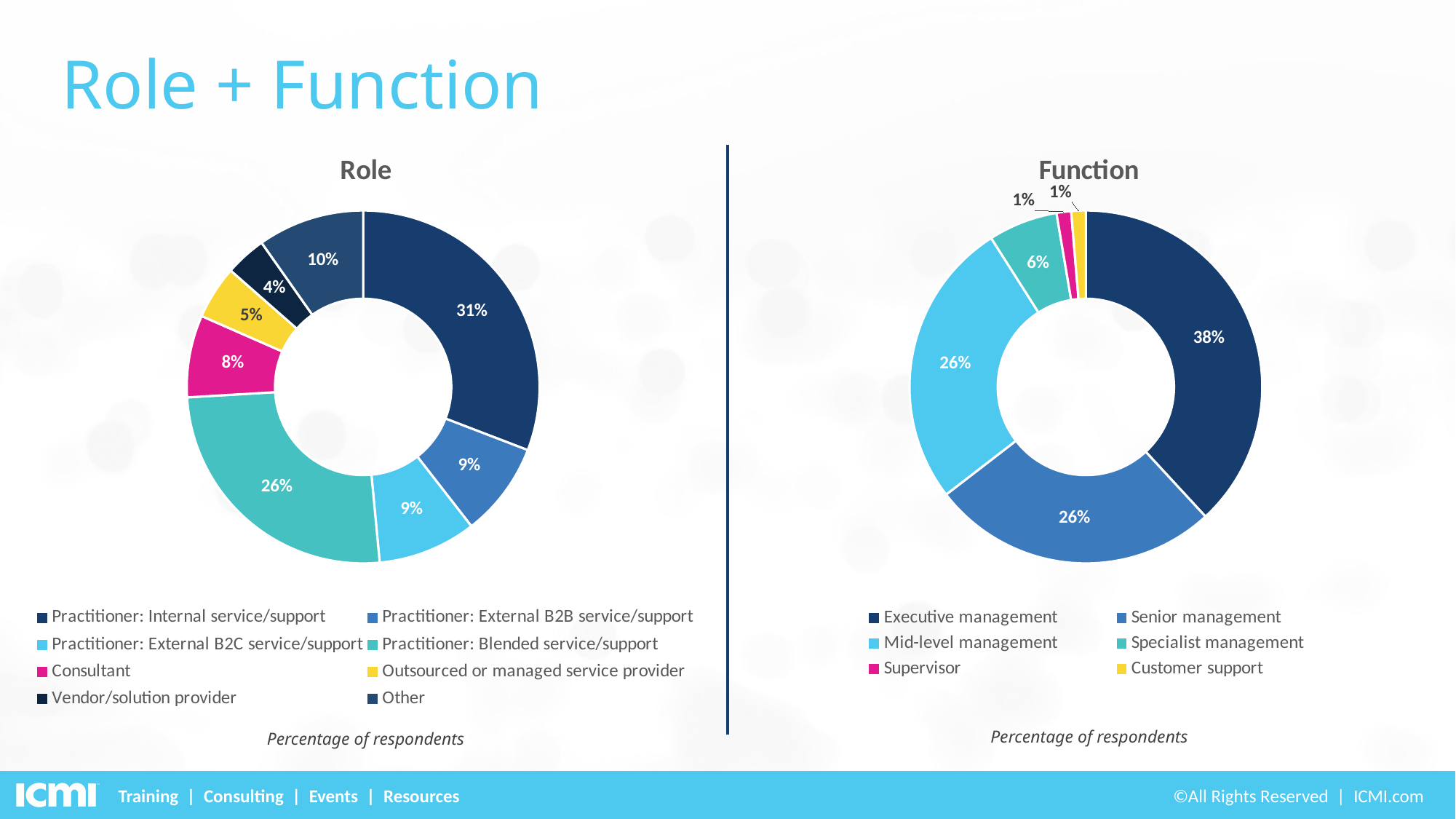
In the Role chart, what percentage of respondents are Practitioner: Internal service/support? 31% What type of chart is used for the Function chart? Donut (pie) chart In the Function chart, what percentage of respondents are in Specialist management? 6% In the Function chart, which category has the largest share? Executive management In the Role chart, which category has the smallest share? Vendor/solution provider In the Function chart, how many categories does the legend list? 6 In the Role chart, how many categories does the legend list? 8 In the Role chart, which category has the largest share? Practitioner: Internal service/support In the Function chart, which is larger: Senior management or Specialist management? Senior management In the Function chart, what percentage of respondents are in Executive management? 38% In the Role chart, what is the difference between the Practitioner: Blended service/support share and the Other share? 16 percentage points In the Role chart, what percentage of respondents are Consultants? 8%